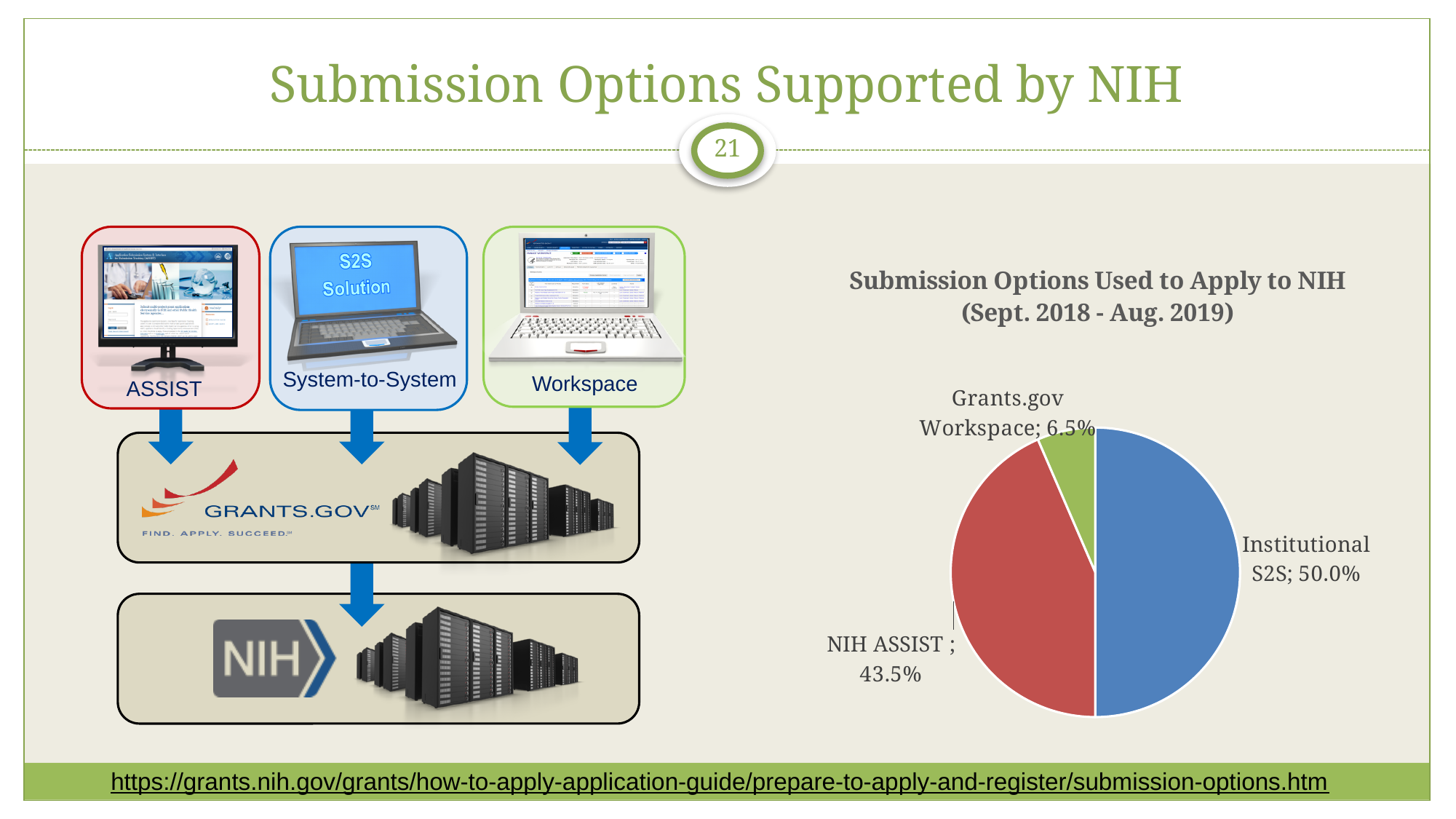
What share of submissions used NIH ASSIST? 43.5% What share of submissions used Institutional S2S? 50.0% Which submission option has the largest share of the pie? Institutional S2S How many slices does the pie chart have? 3 Which submission option has the smallest share of the pie? Grants.gov Workspace What is the difference in percentage points between Institutional S2S and NIH ASSIST? 6.5 Which is larger, the share for NIH ASSIST or the share for Grants.gov Workspace? NIH ASSIST What colour is the Institutional S2S slice? blue What type of chart is shown on the slide? pie chart What is the combined share of NIH ASSIST and Grants.gov Workspace? 50.0% What share of submissions used Grants.gov Workspace? 6.5% What is the title of the chart? Submission Options Used to Apply to NIH (Sept. 2018 - Aug. 2019)